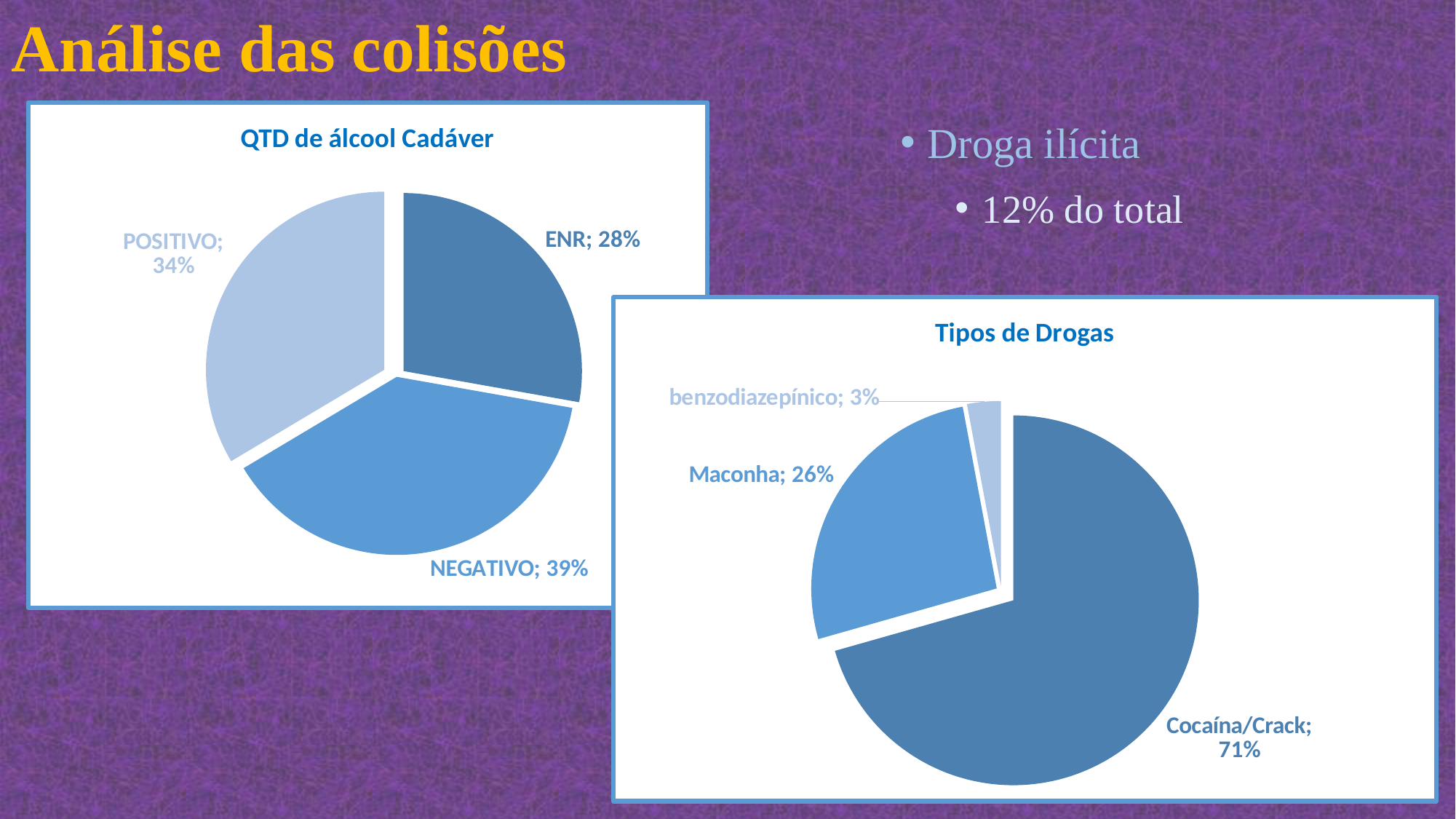
In the 'QTD de álcool Cadáver' chart, which category has the largest slice? NEGATIVO What type of chart is the 'Tipos de Drogas' chart? Pie chart In the 'QTD de álcool Cadáver' chart, how many slices does the pie have? 3 In the 'QTD de álcool Cadáver' chart, which category has the smallest slice? ENR In the 'Tipos de Drogas' chart, what is the share for benzodiazepínico? 3% In the 'Tipos de Drogas' chart, what is the share for Cocaína/Crack? 71% In the 'QTD de álcool Cadáver' chart, what is the share for ENR? 28% In the 'Tipos de Drogas' chart, what is the share for Maconha? 26% In the 'QTD de álcool Cadáver' chart, what is the share for POSITIVO? 34% In the 'Tipos de Drogas' chart, what is the difference in percentage points between Cocaína/Crack and Maconha? 45 In the 'Tipos de Drogas' chart, which category has the smallest slice? benzodiazepínico In the 'QTD de álcool Cadáver' chart, what is the share for NEGATIVO? 39%